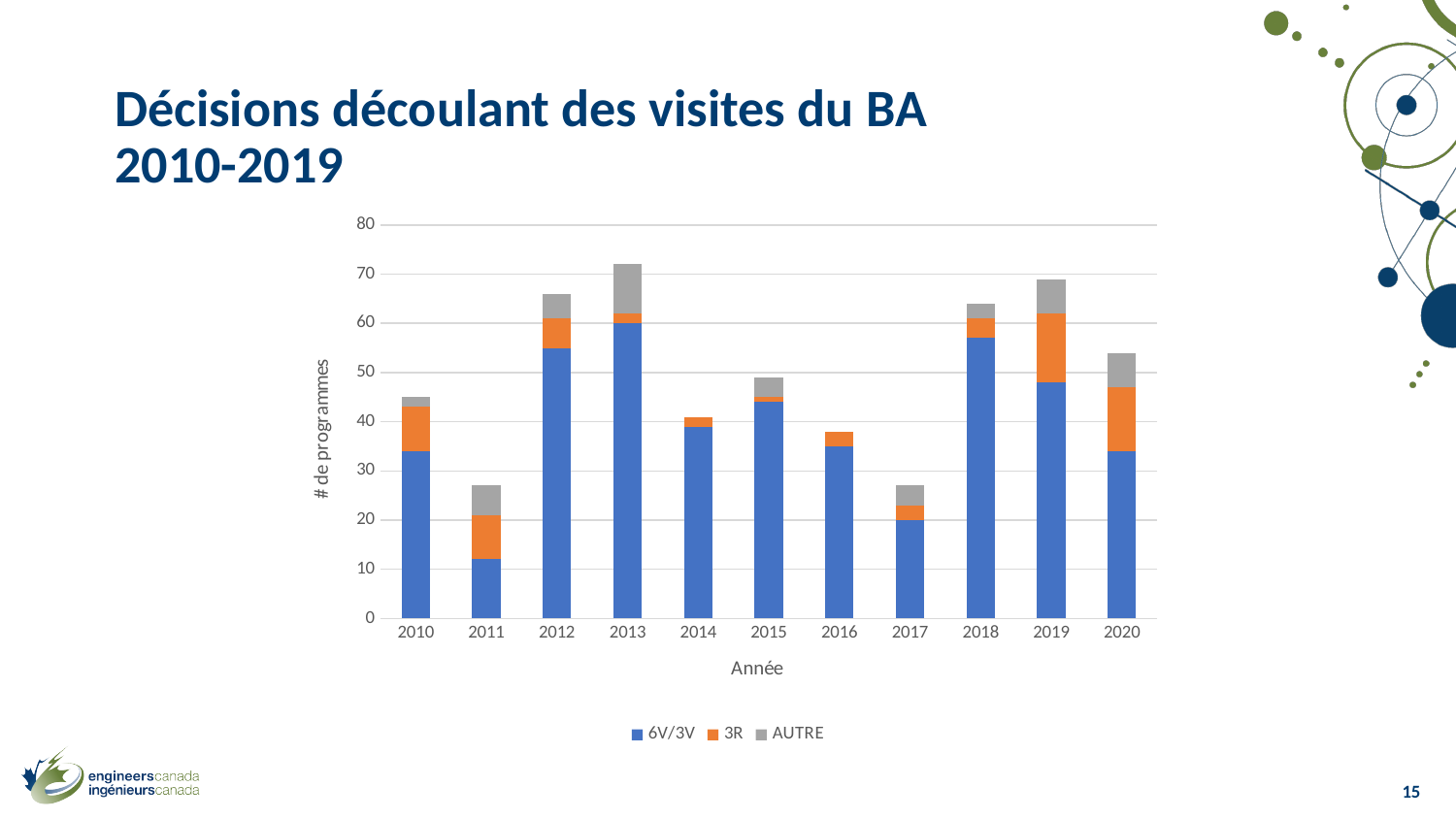
Which year has the tallest stacked bar (highest total number of programmes)? 2013 What kind of chart is shown on the slide? Stacked bar chart How many series does the chart's legend list? 3 Which year has the smallest 6V/3V (blue) segment? 2011 Is the total stacked bar for 2013 greater or less than 60? greater Is the total stacked bar for 2019 greater or less than 60? greater What are the three series listed in the chart's legend? 6V/3V, 3R, AUTRE Is the total stacked bar for 2011 greater or less than 30? less How many years (categories) are shown on the x axis of the chart? 11 Which year has the larger total stacked bar, 2012 or 2014? 2012 Which year has the larger total stacked bar, 2015 or 2018? 2018